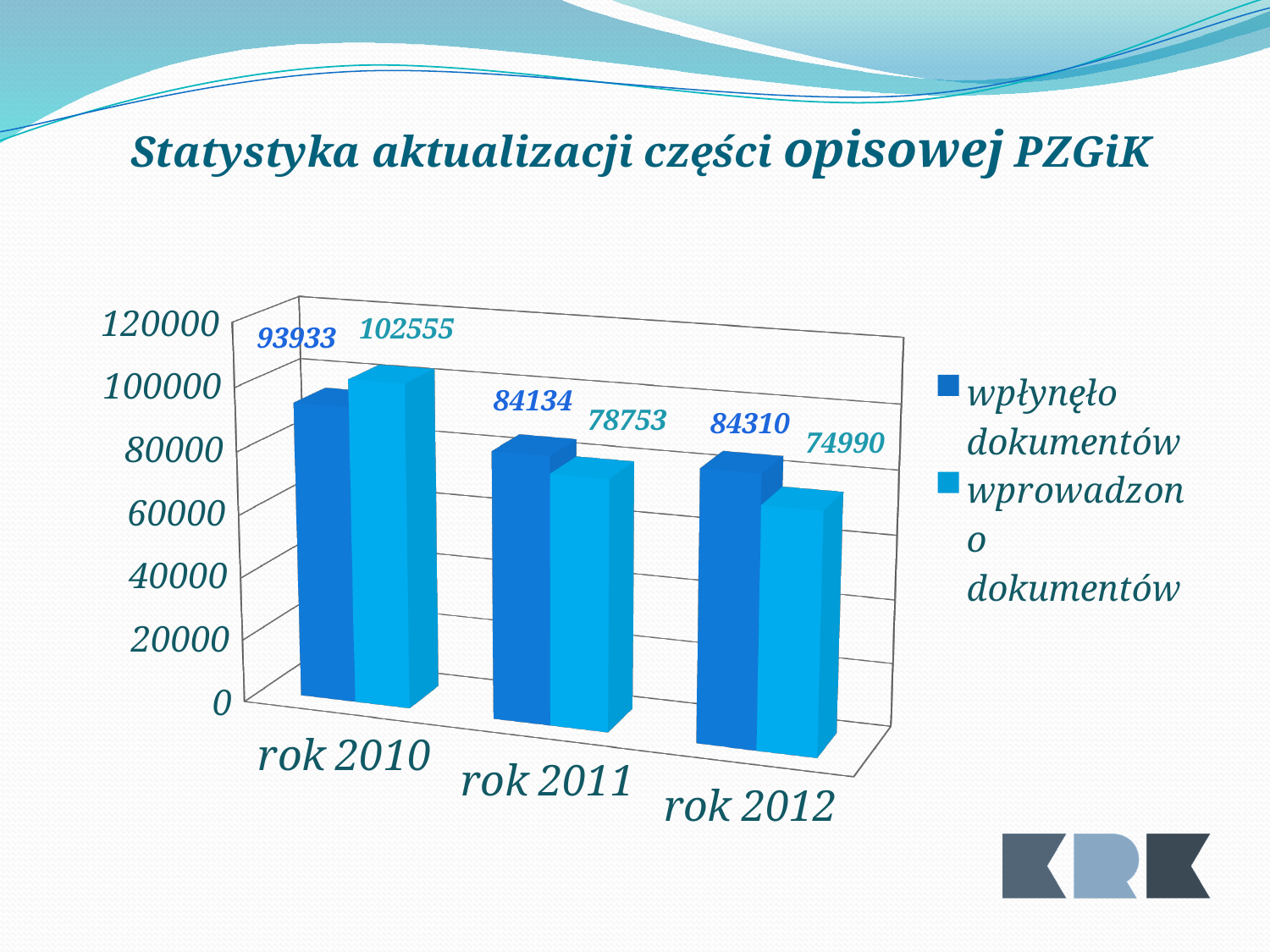
What is the difference between 'wprowadzono dokumentów' and 'wpłynęło dokumentów' in rok 2010? 8622 Does the value of 'wprowadzono dokumentów' rise or fall from rok 2010 to rok 2012? fall What is the value of 'wprowadzono dokumentów' for rok 2010? 102555 How many series does the legend list? 2 What is the value of 'wpłynęło dokumentów' for rok 2010? 93933 Which year has the lowest value for 'wprowadzono dokumentów'? rok 2012 In rok 2011, which is larger: 'wpłynęło dokumentów' or 'wprowadzono dokumentów'? wpłynęło dokumentów What type of chart is shown on the slide? bar chart What is the value of 'wprowadzono dokumentów' for rok 2012? 74990 Which year has the highest value for 'wprowadzono dokumentów'? rok 2010 What is the value of 'wpłynęło dokumentów' for rok 2011? 84134 How many year categories are shown on the x axis? 3